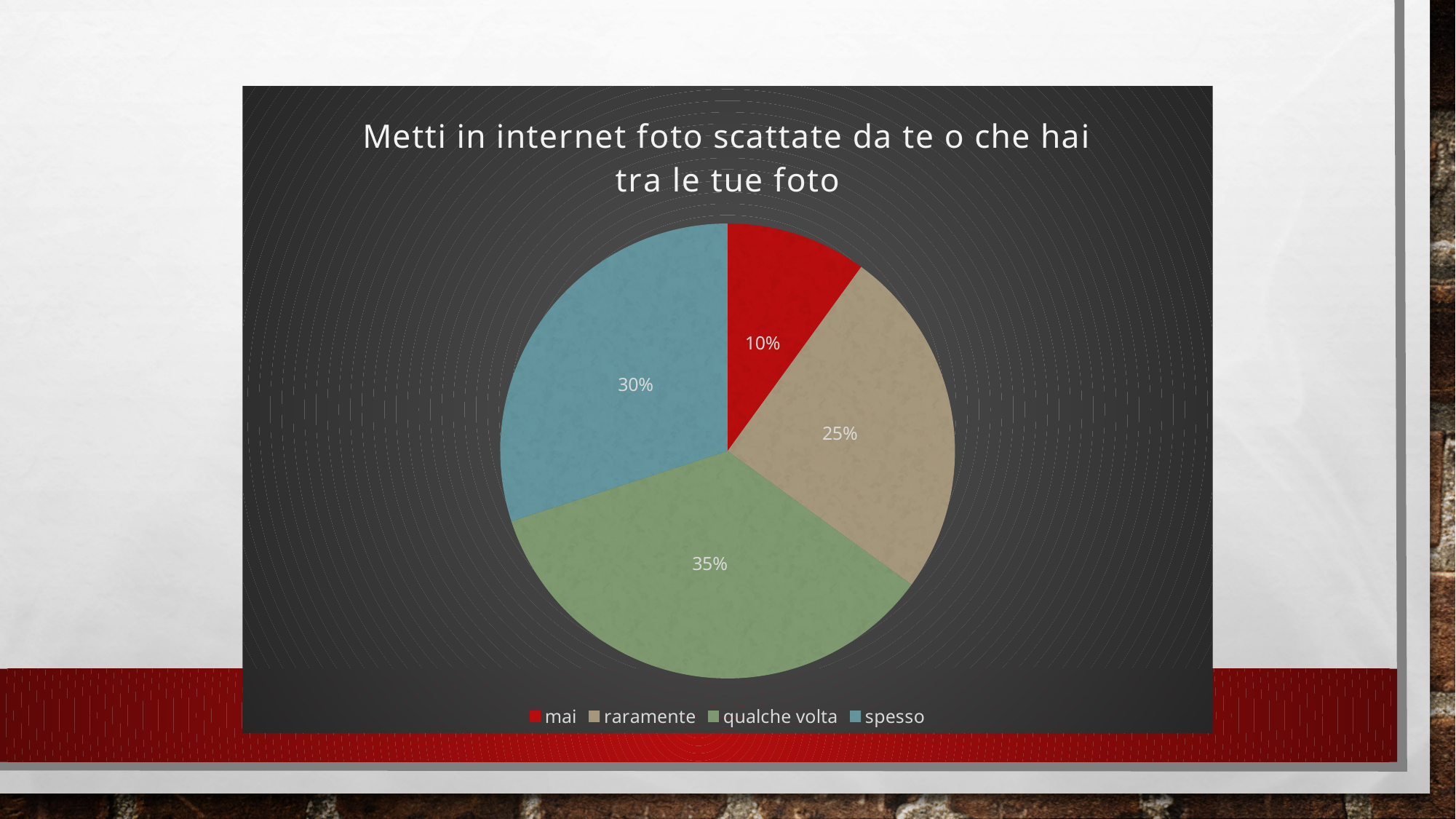
Which is larger, the 'spesso' slice or the 'raramente' slice? spesso What is the difference in percentage points between 'qualche volta' and 'mai'? 25 What percentage of the pie is the 'mai' slice? 10% How many slices does the pie chart have? 4 Which category has the largest share of the pie? qualche volta What percentage of the pie is the 'qualche volta' slice? 35% What colour is the 'mai' slice in the pie chart? red What percentage of the pie is the 'spesso' slice? 30% Which category has the smallest share of the pie? mai What percentage of the pie is the 'raramente' slice? 25% What is the title of the chart? Metti in internet foto scattate da te o che hai tra le tue foto What kind of chart is shown on the slide? pie chart